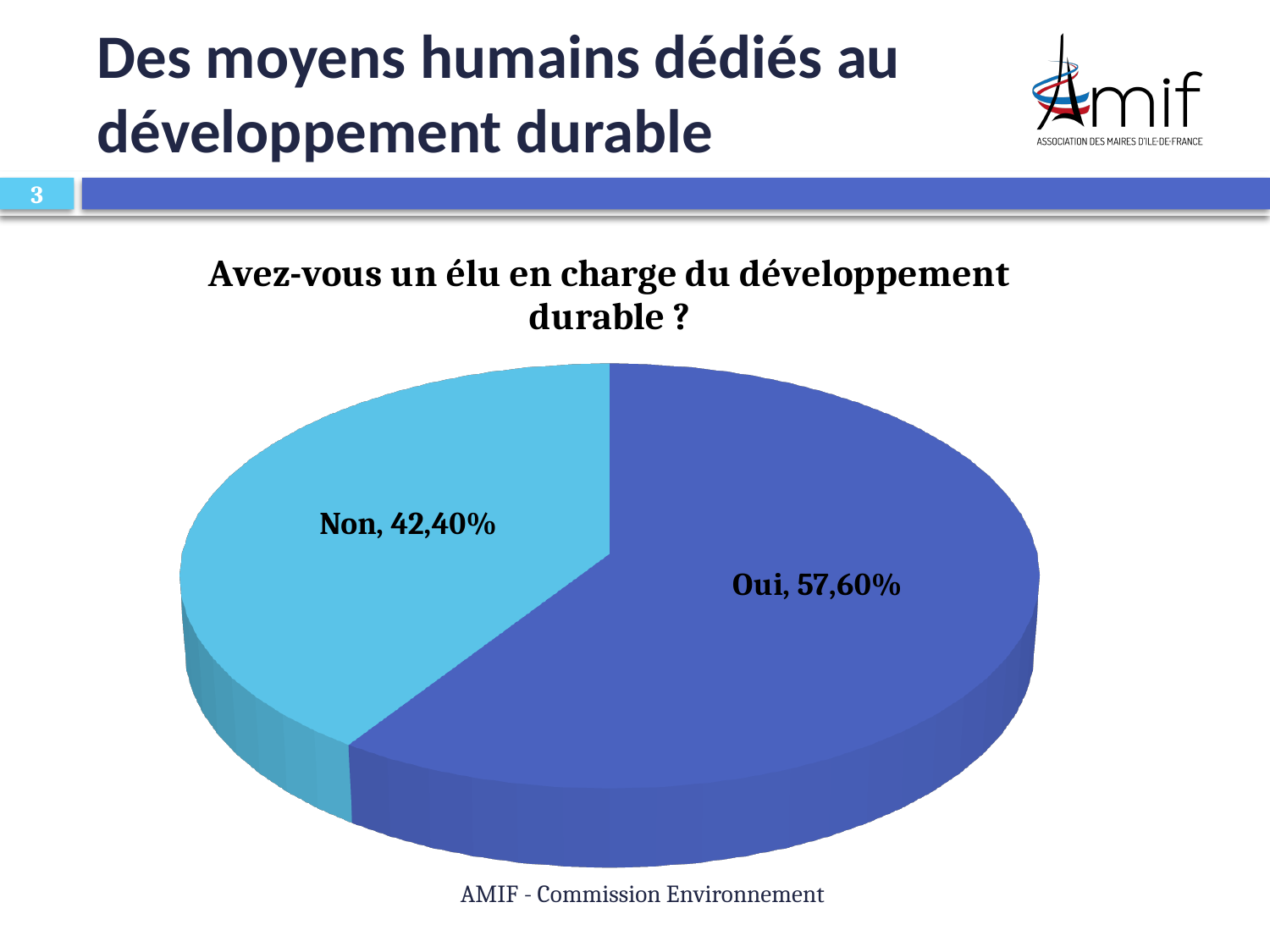
What percentage of respondents answered "Oui"? 57,60% Is the share for "Oui" greater or less than 50%? greater Which response has the smallest share of the pie? Non What is the difference in percentage points between the "Oui" and "Non" slices? 15,20% What is the combined total of the "Oui" and "Non" slices? 100% What type of chart is shown on the slide? pie chart How many slices does the pie chart have? 2 What colour is the "Non" slice? light blue What percentage of respondents answered "Non"? 42,40% Which response has the largest share of the pie? Oui What is the title of the chart? Avez-vous un élu en charge du développement durable ? Which slice is larger, "Oui" or "Non"? Oui